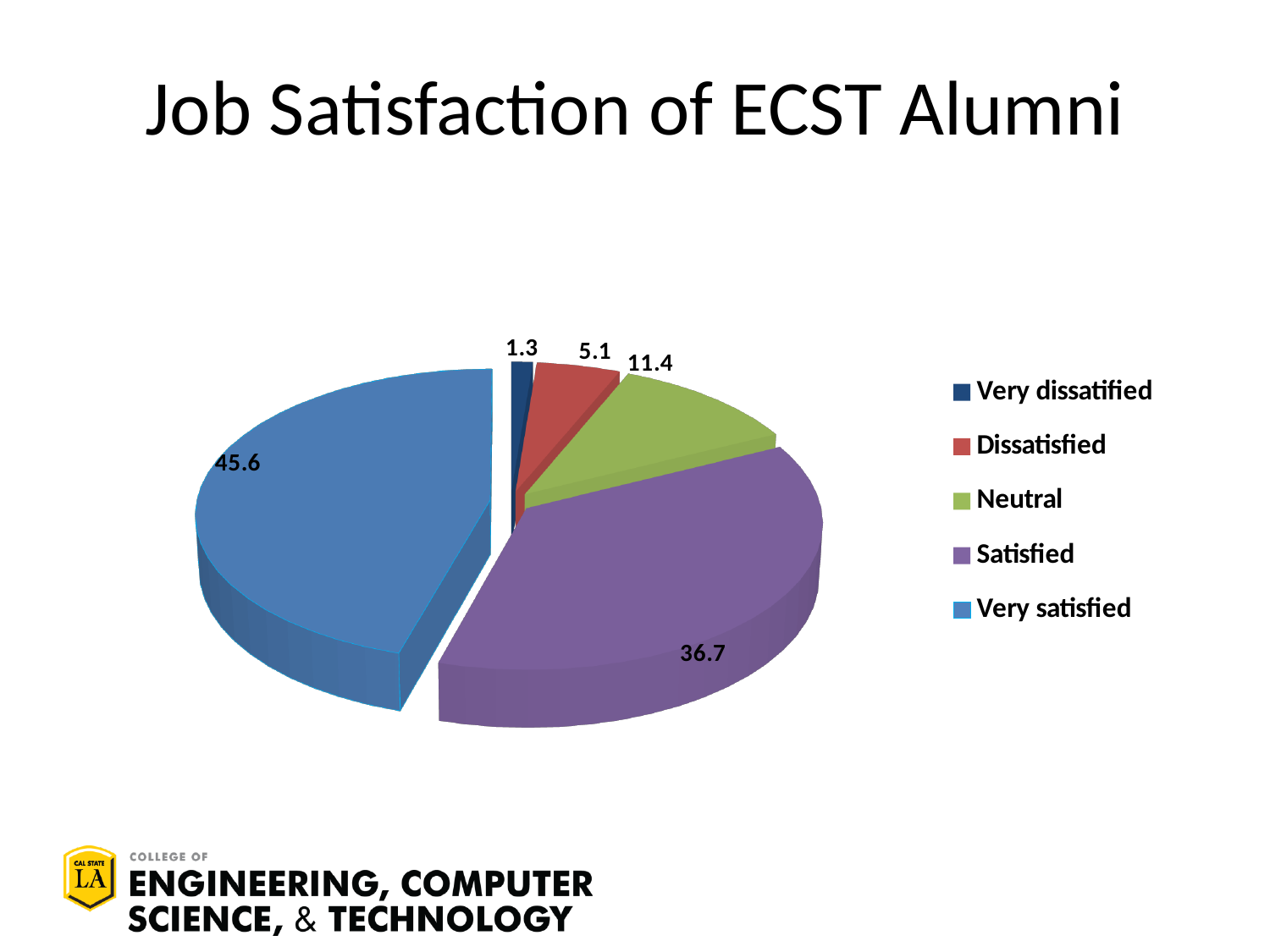
What type of chart is shown on the slide? Pie chart Which is larger, the value for Neutral or the value for Dissatisfied? Neutral What is the value for Satisfied? 36.7 What is the value for Very satisfied? 45.6 What is the value for Dissatisfied? 5.1 Which category has the smallest slice? Very dissatisfied What is the value for Very dissatisfied? 1.3 What is the value for Neutral? 11.4 What is the difference between the values for Very satisfied and Satisfied? 8.9 What is the title of the chart? Job Satisfaction of ECST Alumni How many categories does the legend list? 5 Which category has the largest slice? Very satisfied